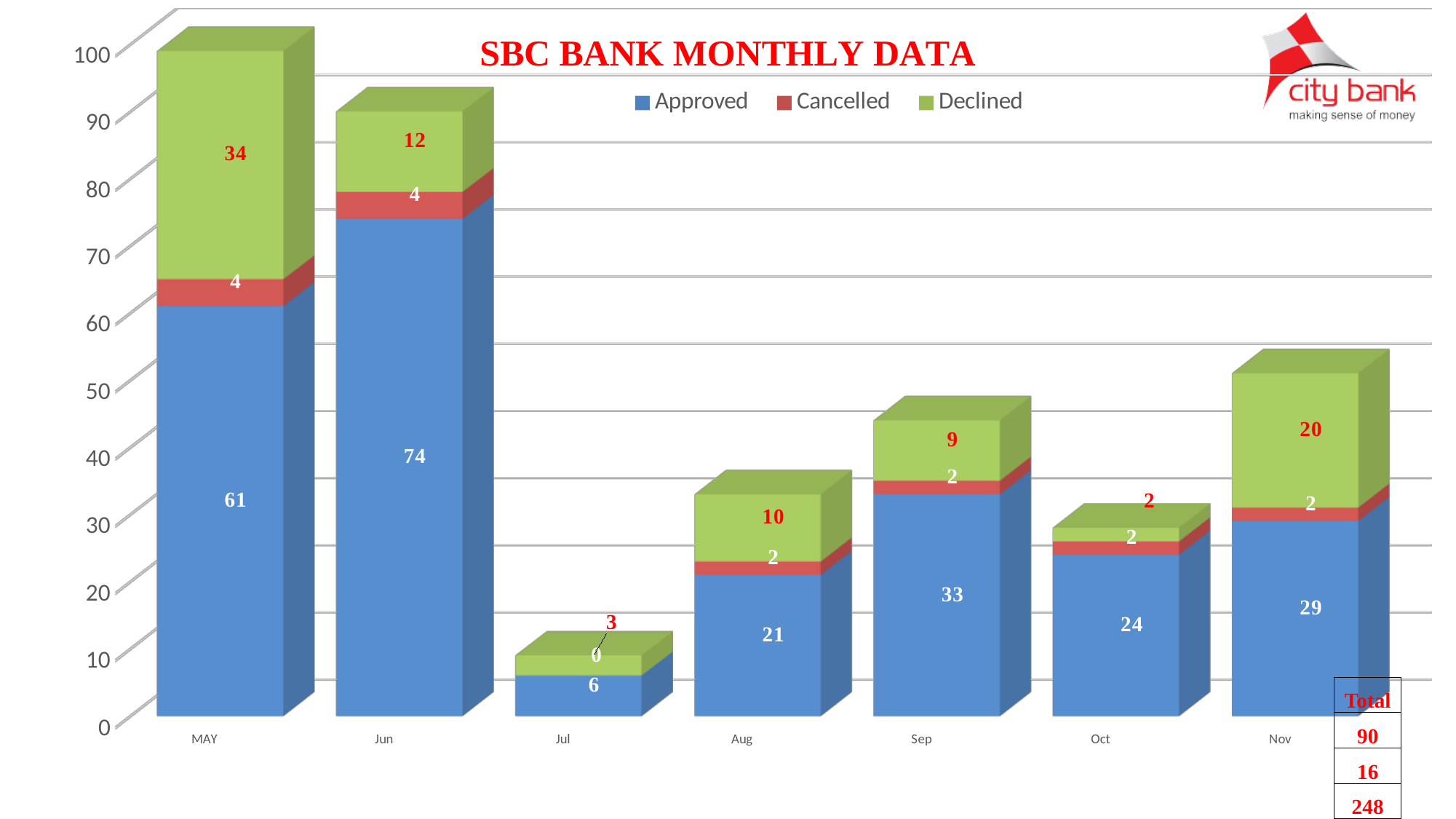
Which is larger, the Approved value for Sep or the Approved value for Oct? Sep How many months are shown on the x axis? 7 What is the total of the stacked bar for Aug? 33 What is the Declined value for MAY? 34 Which month has the highest Approved value? Jun Which month has the lowest Declined value? Oct What is the difference between the Declined values for Nov and Aug? 10 What is the Approved value for Jun? 74 How many series does the legend list? 3 What is the title of the chart? SBC BANK MONTHLY DATA What is the Cancelled value for Jul? 0 What type of chart is shown on the slide? stacked bar chart